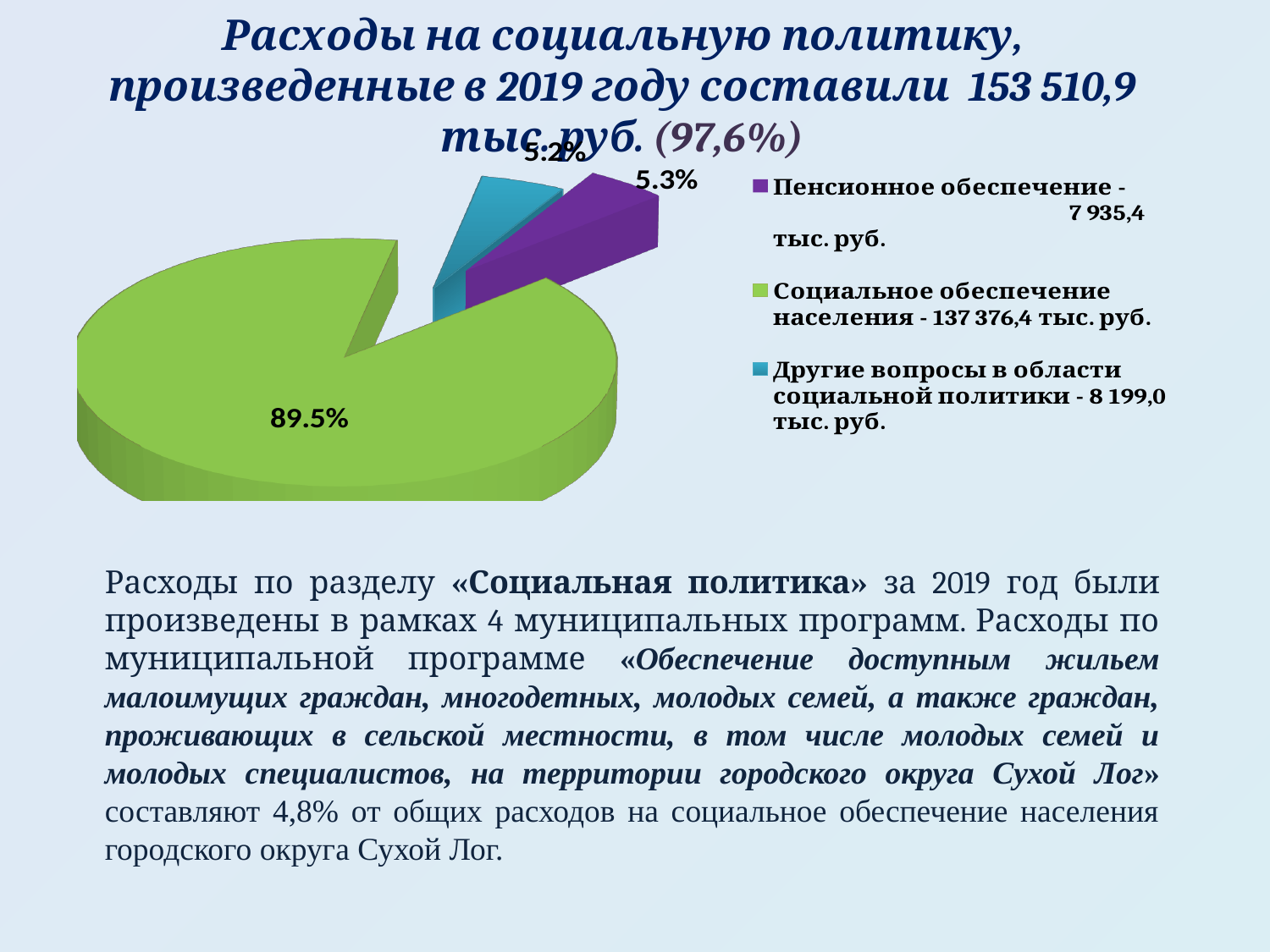
How many categories does the pie chart have? 3 Which category has the largest slice of the pie chart? Социальное обеспечение населения According to the legend, what is the amount for Пенсионное обеспечение? 7 935,4 тыс. руб. Based on the legend amounts, which is larger: Пенсионное обеспечение or Другие вопросы в области социальной политики? Другие вопросы в области социальной политики What share of the pie does the largest slice (Социальное обеспечение населения) represent? 89.5% How many entries does the legend of the pie chart list? 3 According to the legend, what is the amount for Другие вопросы в области социальной политики? 8 199,0 тыс. руб. What is the difference between the legend amounts for Другие вопросы в области социальной политики and Пенсионное обеспечение? 263,6 тыс. руб. According to the legend, what is the amount for Социальное обеспечение населения? 137 376,4 тыс. руб. What type of chart is shown on the slide? pie chart Based on the amounts in the legend, which category has the smallest value? Пенсионное обеспечение What colour is the slice for Социальное обеспечение населения in the pie chart? green